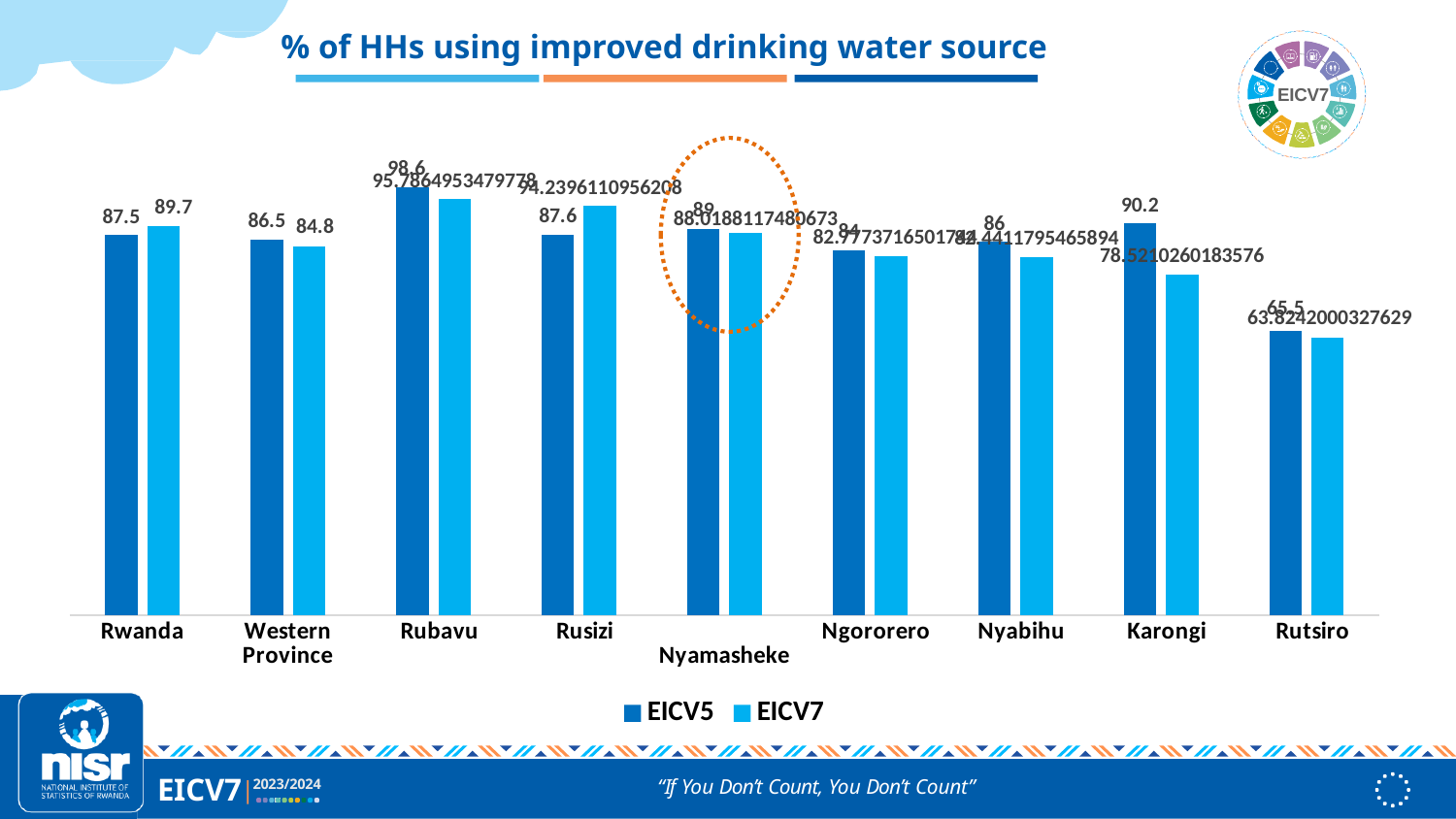
How many categories are shown on the x axis? 9 What is the EICV7 value for Rwanda? 89.7 Which category has the lowest EICV7 value? Rutsiro Which category has the highest EICV5 value? Rubavu What is the EICV5 value for Western Province? 86.5 Which category's bars are highlighted with a dotted orange circle? Nyamasheke For Rusizi, which is larger: the EICV5 value or the EICV7 value? EICV7 What is the EICV5 value for Karongi? 90.2 What kind of chart is shown on the slide? Bar chart What is the difference between the EICV7 and EICV5 values for Rwanda? 2.2 What is the EICV5 value for Rutsiro? 65.5 How many series does the legend list? 2